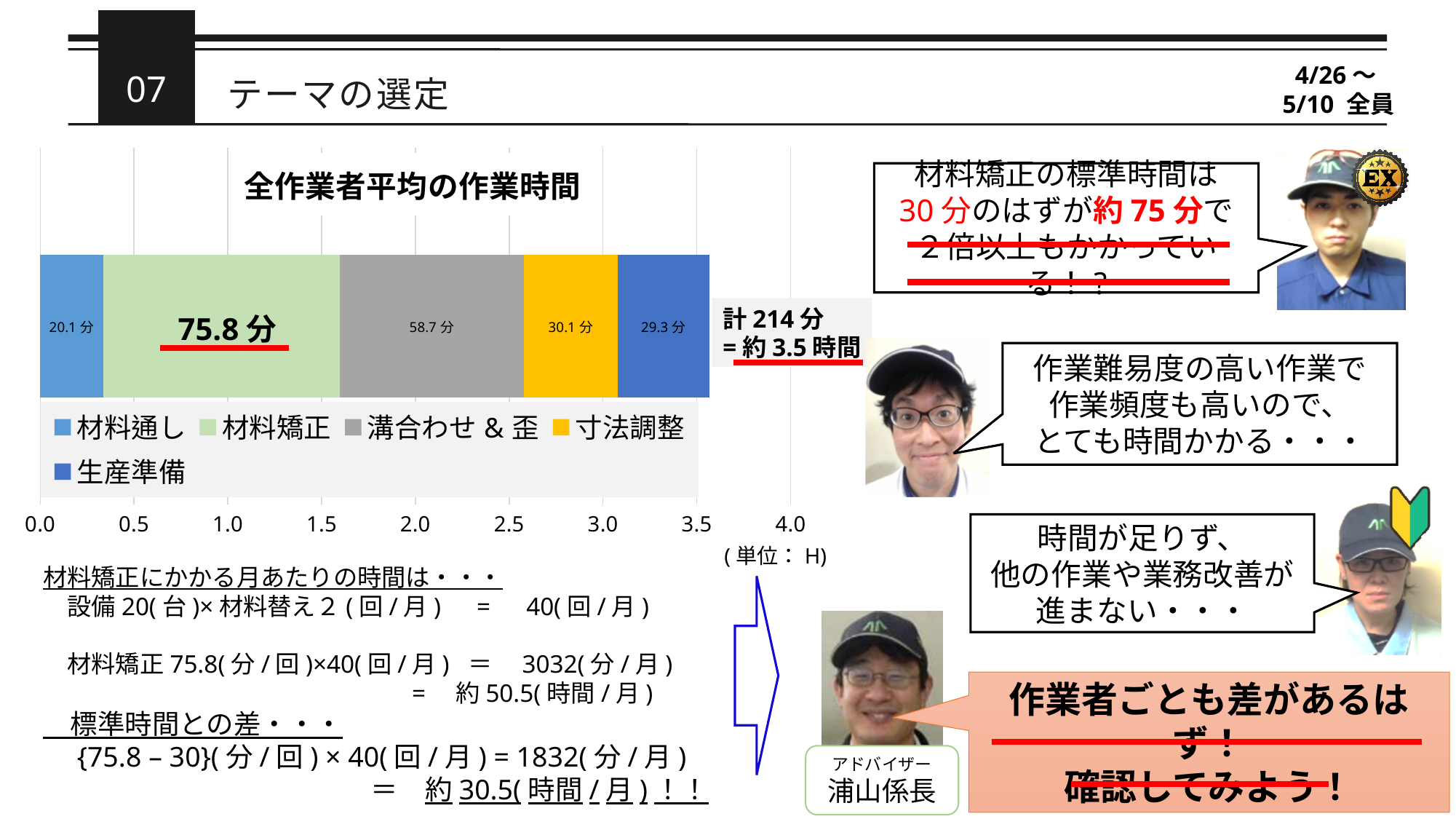
What is the value labelled for 材料通し? 20.1 分 How many series does the chart legend list? 5 What is the difference between the values for 材料矯正 and 溝合わせ & 歪? 17.1 分 What is the total of the stacked bar, as printed on the slide? 214 分 Which is larger, the value for 寸法調整 or the value for 生産準備? 寸法調整 What is the value labelled for 溝合わせ & 歪? 58.7 分 What is the title of the chart? 全作業者平均の作業時間 Which segment of the bar has the largest value? 材料矯正 Which segment of the bar has the smallest value? 材料通し What type of chart is shown on the slide? stacked bar chart What is the value labelled for 材料矯正? 75.8 分 What is the value labelled for 生産準備? 29.3 分